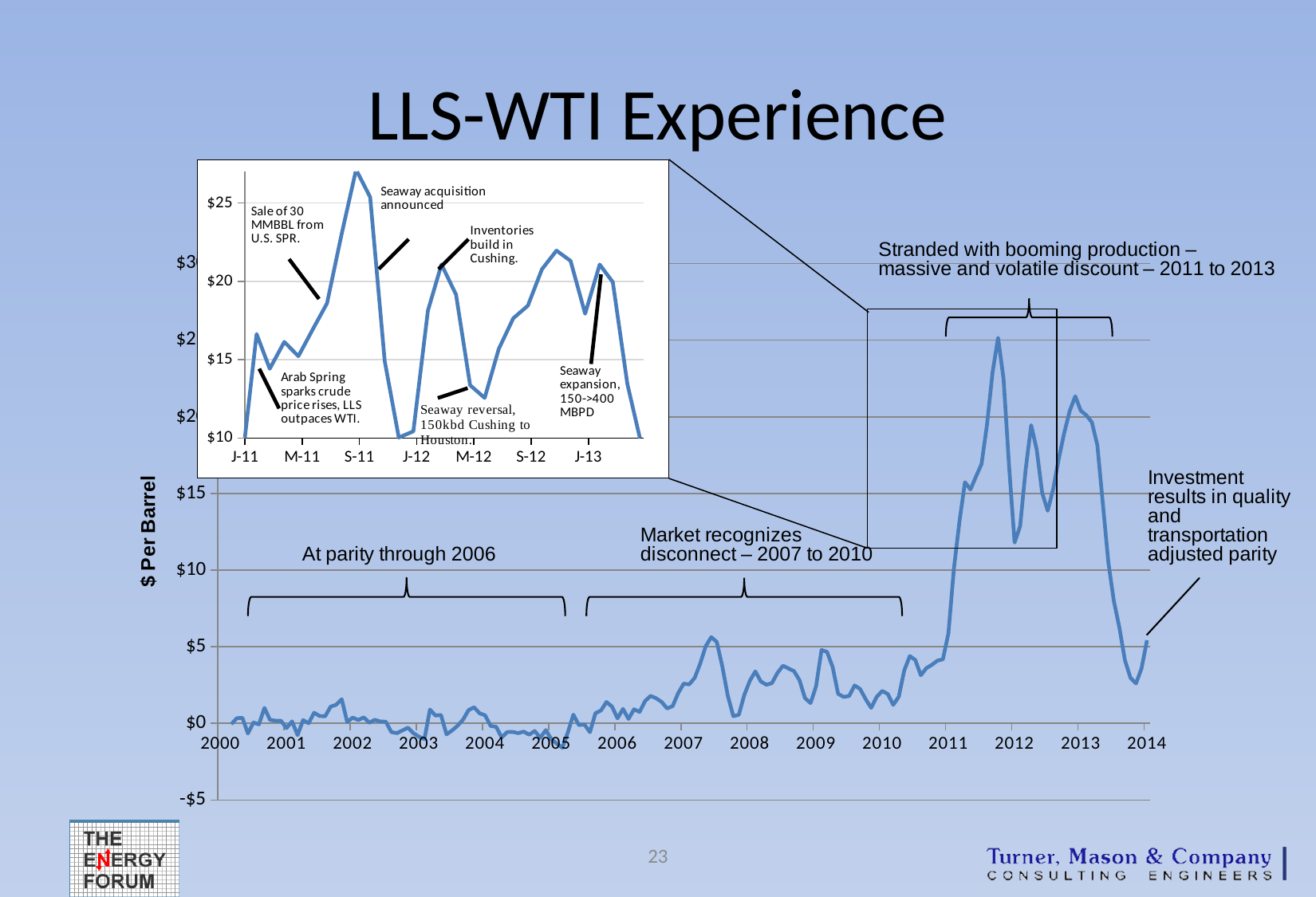
On the main chart, is the peak value reached in late 2011 greater or less than $20? greater On the main chart, is the value at the start of 2010 greater or less than $5? less How many year labels are shown on the x axis of the main chart? 15 What kind of chart is the main chart on the slide? line chart On the main chart, do the values generally rise or fall from 2006 to the 2011 peak? rise On the inset chart, do the values rise or fall from S-11 to J-12? fall What is the y-axis label of the main chart? $ Per Barrel On the main chart, is the peak value in 2013 greater or less than $20? greater How many x-axis labels are shown on the inset chart? 7